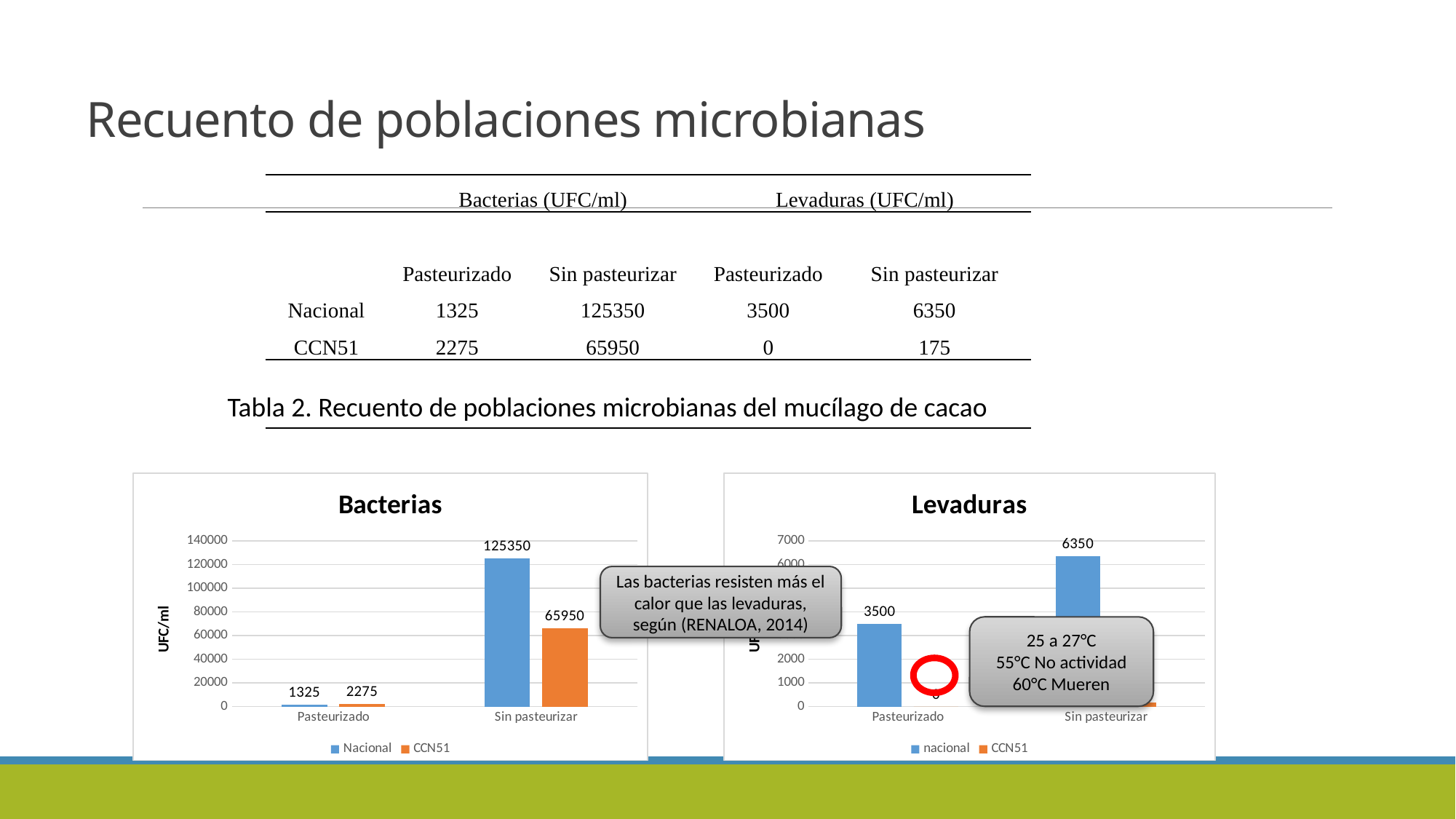
In the Bacterias chart, what is the difference between the Nacional and CCN51 values for Sin pasteurizar? 59400 In the Levaduras chart, what is the difference between the nacional values for Sin pasteurizar and Pasteurizado? 2850 In the Bacterias chart, is the value for CCN51 in Sin pasteurizar greater or less than 60000? greater What kind of chart is the Levaduras chart? bar chart In the Levaduras chart, what is the value for nacional in the Sin pasteurizar category? 6350 In the Bacterias chart, which series has the higher value in the Sin pasteurizar category? Nacional In the Levaduras chart, is the value for nacional in Sin pasteurizar greater or less than 6000? greater In the Levaduras chart, what is the value for nacional in the Pasteurizado category? 3500 In the Bacterias chart, what is the value for Nacional in the Sin pasteurizar category? 125350 What is the y-axis label of the Bacterias chart? UFC/ml In the Bacterias chart, what is the value for CCN51 in the Pasteurizado category? 2275 How many series does the legend of the Bacterias chart list? 2